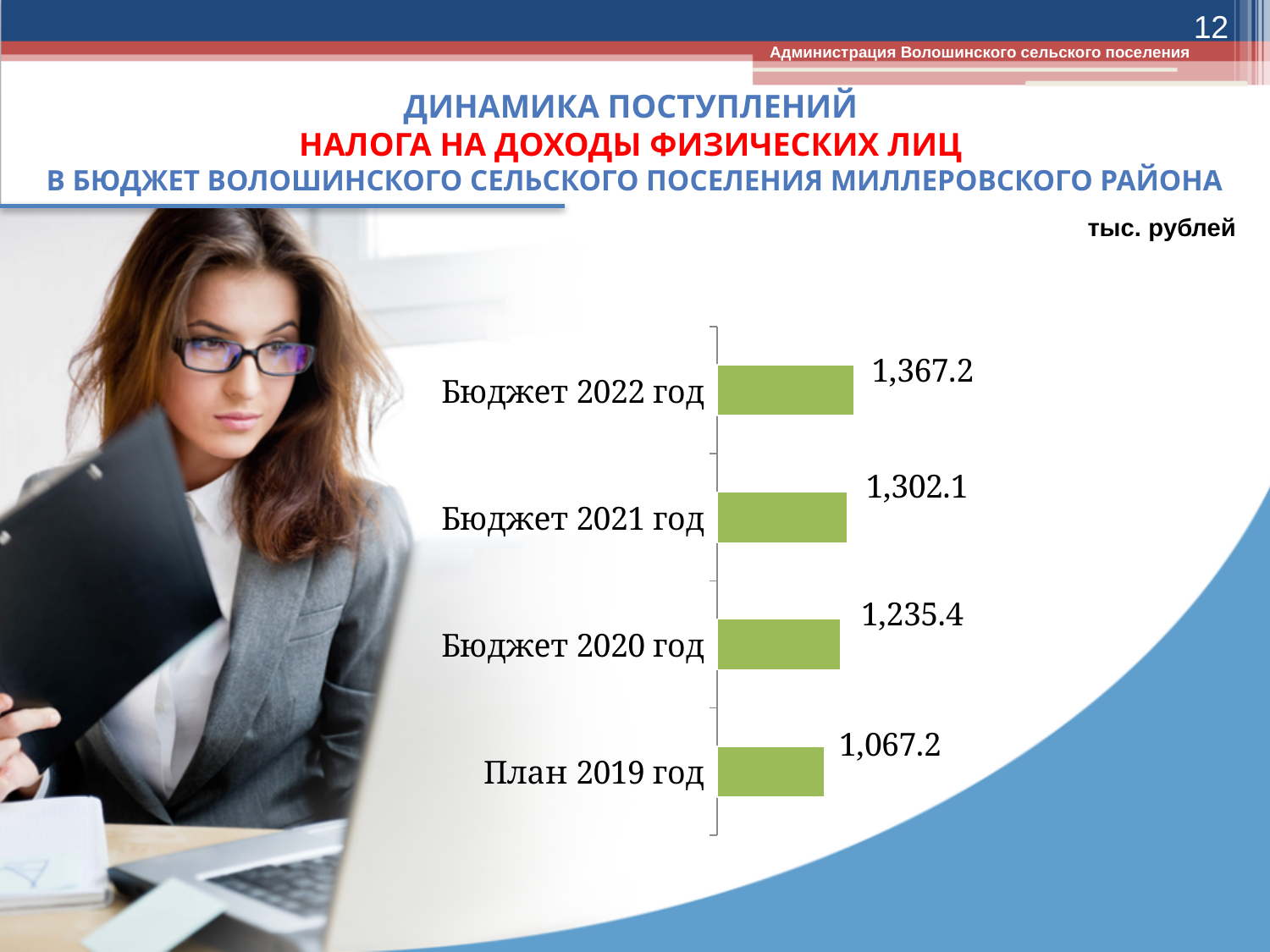
What is the difference between the values for Бюджет 2022 год and План 2019 год? 300.0 What is the value for Бюджет 2022 год? 1,367.2 What is the value for Бюджет 2020 год? 1,235.4 What is the difference between the values for Бюджет 2022 год and Бюджет 2021 год? 65.1 What is the value for Бюджет 2021 год? 1,302.1 Which category has the highest value? Бюджет 2022 год How many categories are shown in the chart? 4 What kind of chart is shown on the slide? Bar chart What is the value for План 2019 год? 1,067.2 Which category has the lowest value? План 2019 год Which is larger, the value for Бюджет 2020 год or the value for План 2019 год? Бюджет 2020 год In what units are the chart values given, according to the slide? тыс. рублей